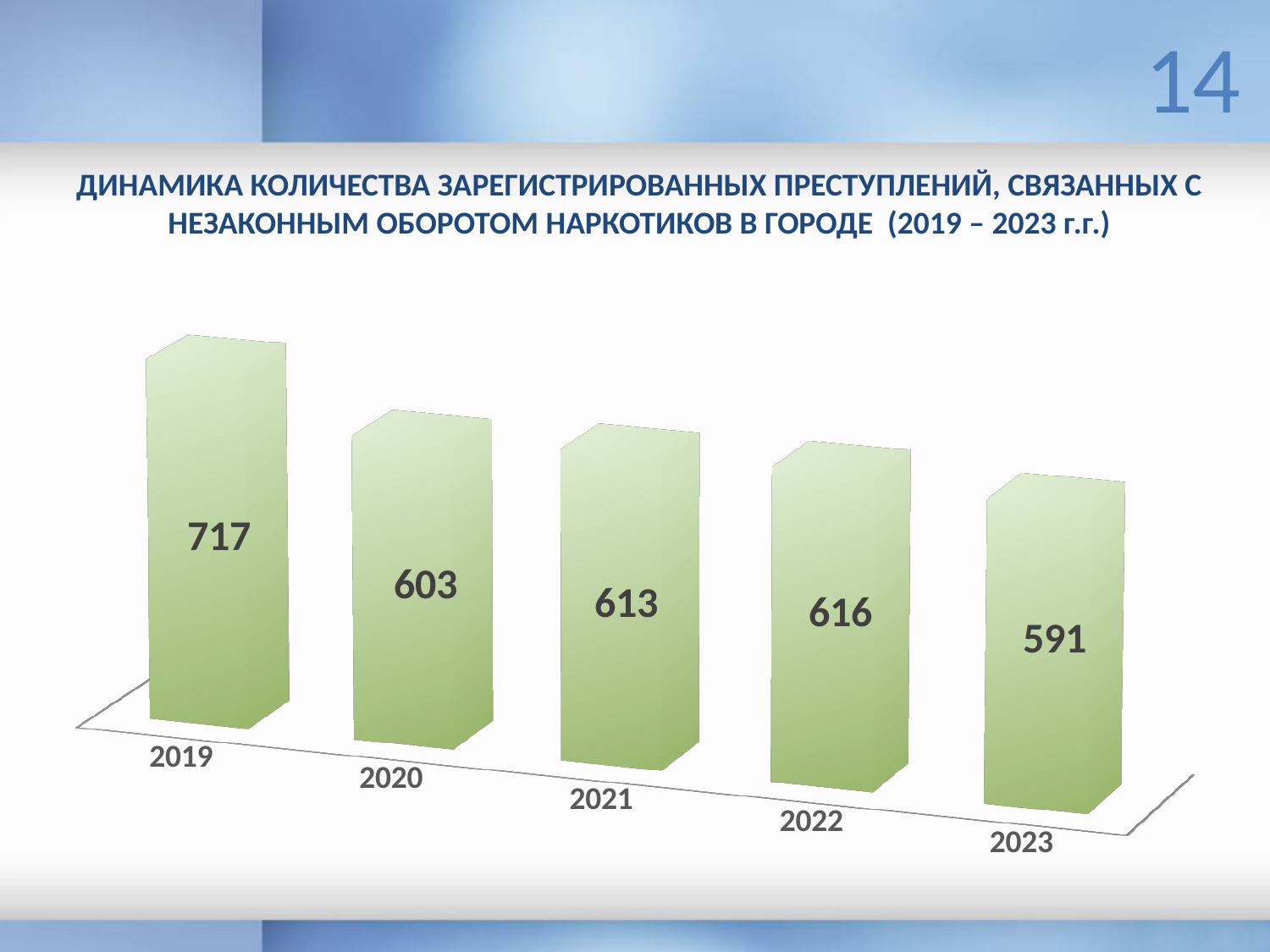
What is the value for 2023? 591 What is the value for 2019? 717 What is the value for 2020? 603 What kind of chart is shown on the slide? bar chart Which year has the highest value? 2019 What is the difference between the values for 2019 and 2020? 114 What is the value for 2022? 616 Which year has the lowest value? 2023 What is the difference between the values for 2022 and 2023? 25 What is the value for 2021? 613 How many years are shown on the chart? 5 Which is larger, the value for 2019 or the value for 2023? 2019